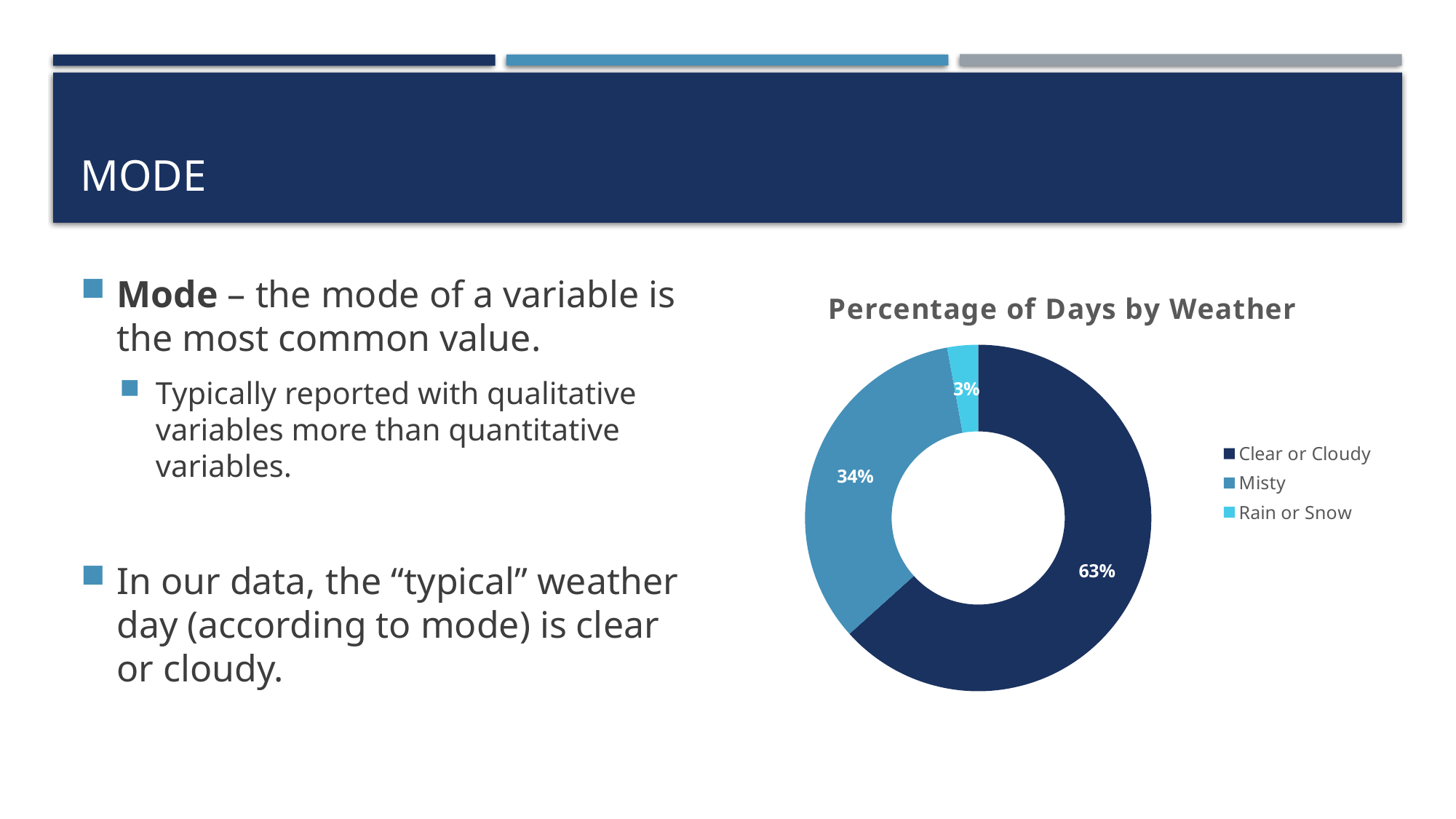
What percentage of days are Misty? 34% What is the title of the chart? Percentage of Days by Weather Which weather category has the smallest share of days? Rain or Snow Which weather category has the largest share of days? Clear or Cloudy What kind of chart is shown on the slide? Doughnut (pie) chart What is the difference in percentage points between Clear or Cloudy and Misty? 29 What percentage of days are Rain or Snow? 3% How many weather categories are shown in the chart? 3 What percentage of days are Clear or Cloudy? 63% Which legend entry is shown in the lightest blue colour? Rain or Snow What is the difference in percentage points between Misty and Rain or Snow? 31 Which has a larger share of days, Misty or Rain or Snow? Misty